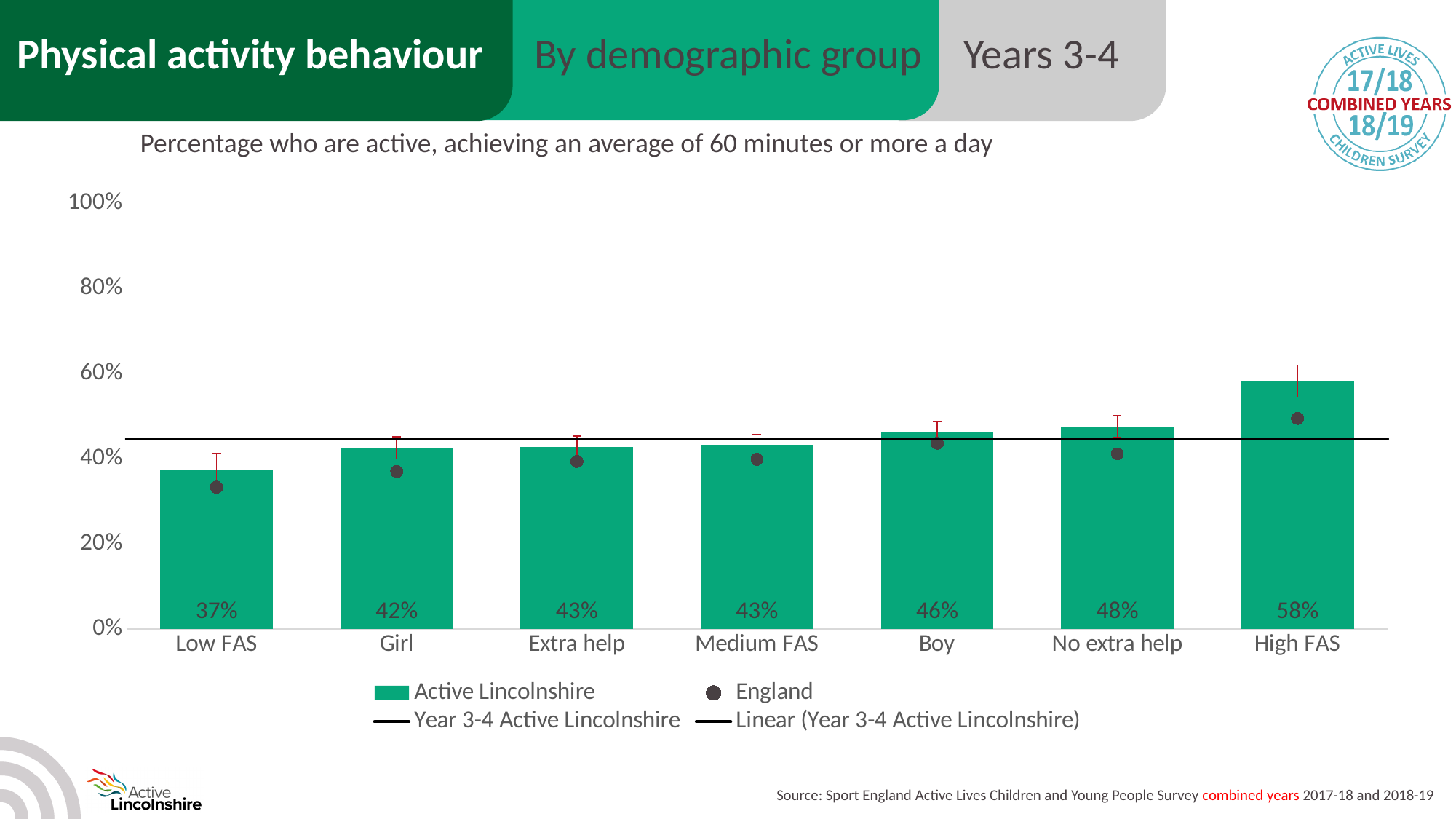
How many demographic categories are shown on the x axis? 7 Is the England value for High FAS greater or less than 40%? greater Which category has the highest Active Lincolnshire value? High FAS Is the England value for Low FAS greater or less than 40%? less Which category has the lowest Active Lincolnshire value? Low FAS What is the Active Lincolnshire value for Boy? 46% What is the subtitle describing what the chart measures? Percentage who are active, achieving an average of 60 minutes or more a day What kind of chart is this? bar chart What is the Active Lincolnshire value for High FAS? 58% What is the difference between the Active Lincolnshire values for High FAS and Low FAS? 21% Which has a higher Active Lincolnshire value, Boy or Girl? Boy What is the Active Lincolnshire value for Low FAS? 37%